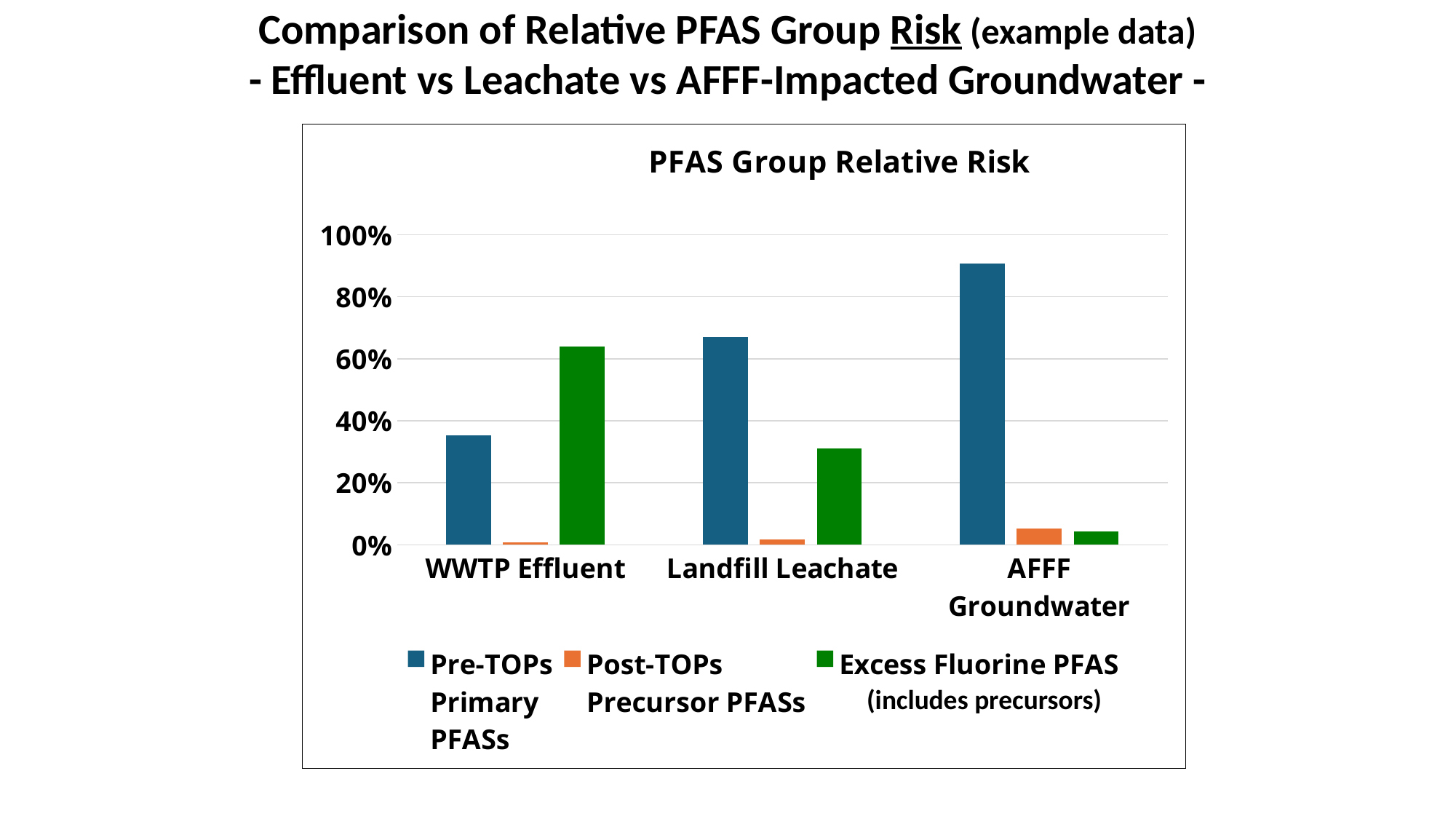
Which category has the highest Pre-TOPs Primary PFASs bar? AFFF Groundwater What is the title shown inside the chart area? PFAS Group Relative Risk Which category has the highest Excess Fluorine PFAS bar? WWTP Effluent Is the Pre-TOPs Primary PFASs value for AFFF Groundwater greater or less than 80%? greater Is the Excess Fluorine PFAS value for Landfill Leachate greater or less than 40%? less For WWTP Effluent, which is larger: the Pre-TOPs Primary PFASs bar or the Excess Fluorine PFAS bar? Excess Fluorine PFAS How many series does the chart's legend list? 3 For Landfill Leachate, which is larger: the Pre-TOPs Primary PFASs bar or the Excess Fluorine PFAS bar? Pre-TOPs Primary PFASs Is the Excess Fluorine PFAS value for WWTP Effluent greater or less than 40%? greater What kind of chart is shown on the slide? bar chart How many categories are shown on the x axis of the chart? 3